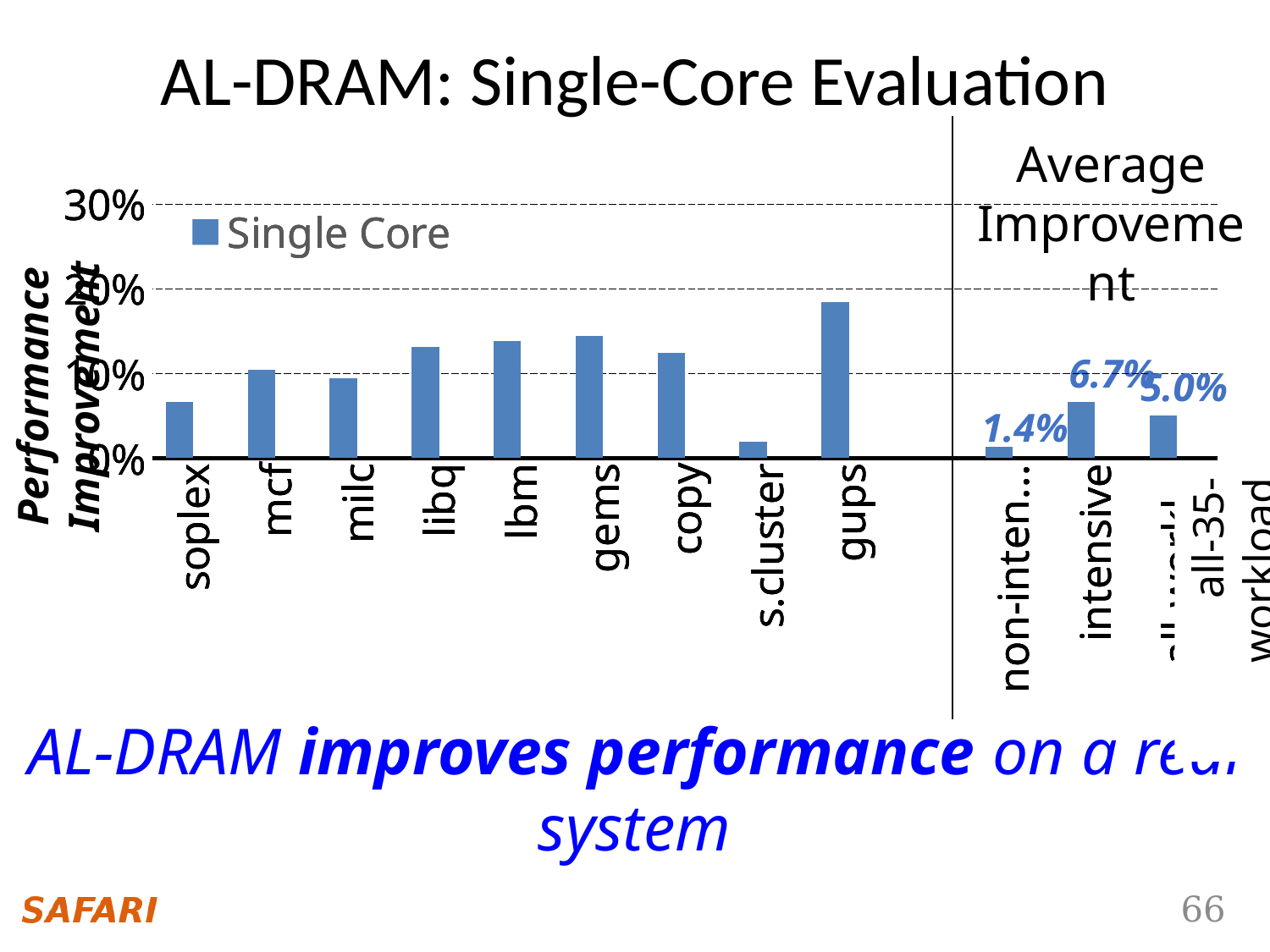
How many individual benchmark bars are plotted to the left of the vertical divider line? 9 What is the average performance improvement labelled for all-35-workload? 5.0% What is the average performance improvement labelled for the intensive workloads? 6.7% What is the name of the series in the legend? Single Core What is the average performance improvement labelled for the non-intensive workloads? 1.4% Which has a larger performance improvement, gups or copy? gups Which benchmark has the lowest performance improvement among the individual benchmarks to the left of the divider? s.cluster Which benchmark has the highest performance improvement? gups How many series does the legend list? 1 What type of chart is shown on the slide? bar chart Is the performance improvement for gups greater or less than 30%? less What is the difference between the intensive and non-intensive average improvements? 5.3%